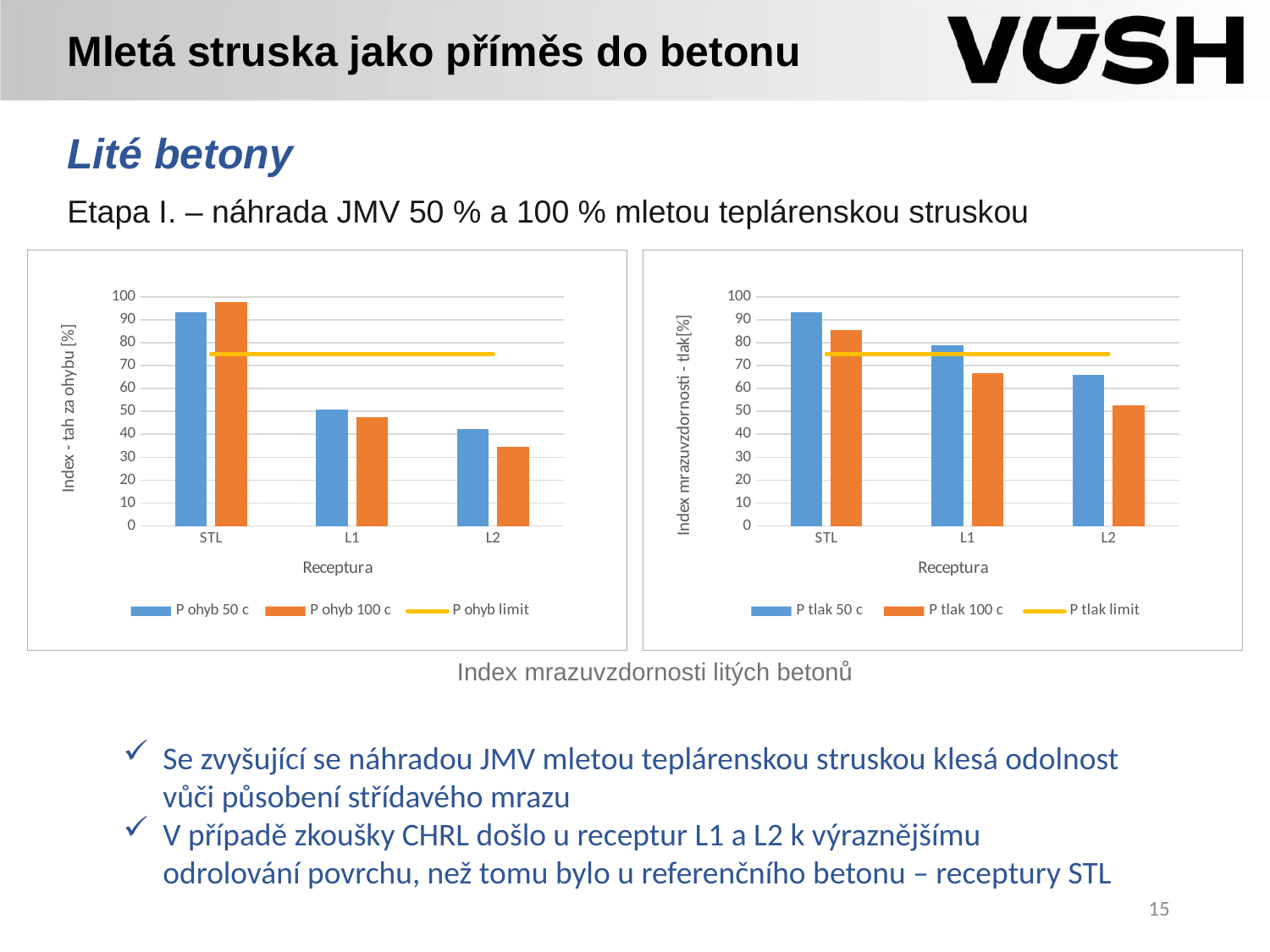
What is the x-axis title of the left chart? Receptura In the right chart, is the value of P tlak 100 c for L2 greater or less than 60? less In the right chart, do the P tlak 50 c values rise or fall from STL to L2? fall In the left chart, is the value of P ohyb 50 c for L1 greater or less than 70? less How many categories are shown on the x axis of the right chart (Index mrazuvzdornosti - tlak)? 3 In the left chart, which category has the highest value for P ohyb 100 c? STL In the left chart, which category has the lowest value for P ohyb 50 c? L2 How many series does the legend of the left chart list? 3 In the left chart, is the value of P ohyb 100 c for STL greater or less than 90? greater What kind of chart is the left chart (Index - tah za ohybu)? bar chart In the right chart, which category has the lowest value for P tlak 100 c? L2 In the right chart, which is larger for L1: P tlak 50 c or P tlak 100 c? P tlak 50 c